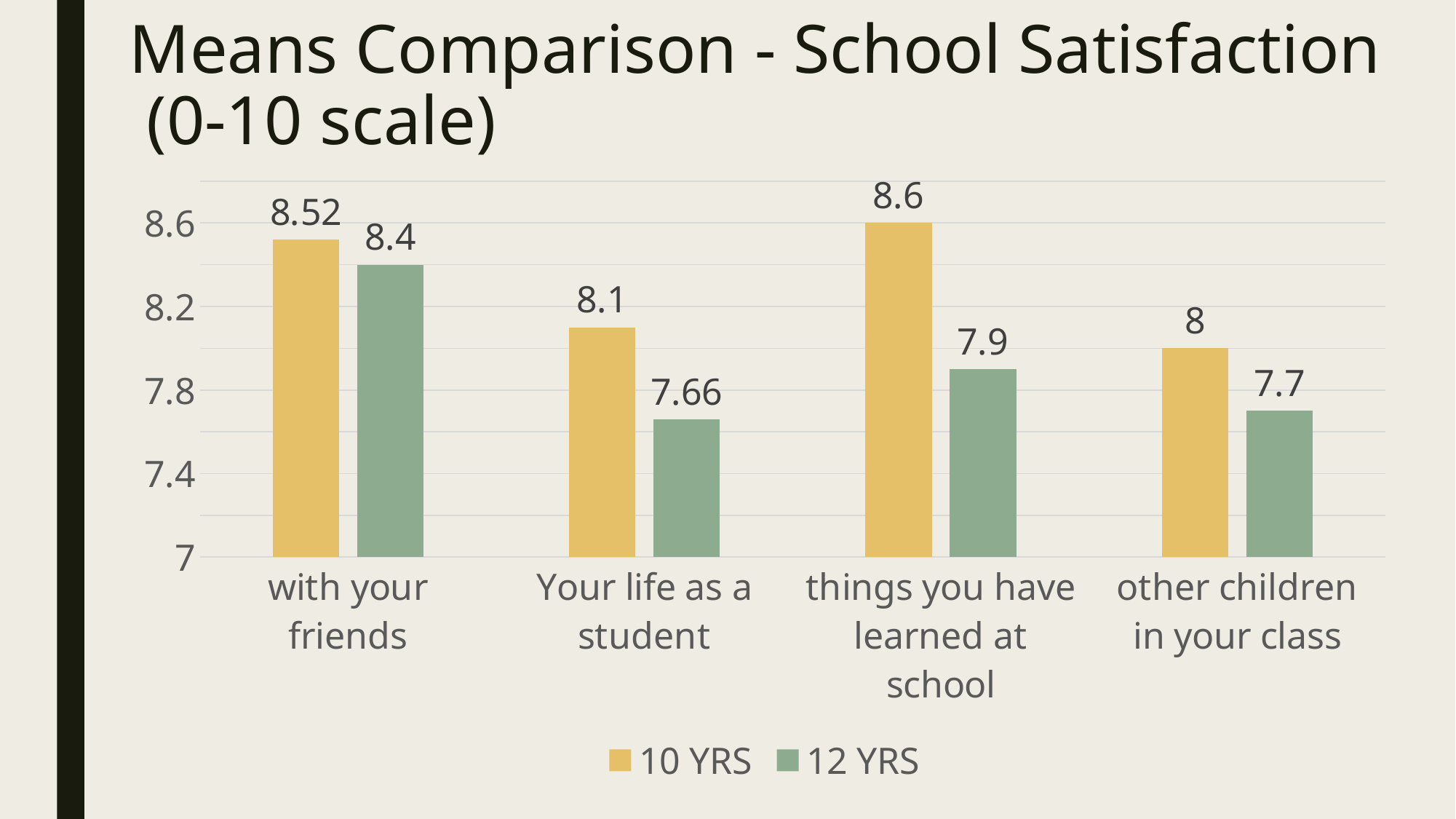
Which category has the highest 10 YRS value? things you have learned at school Which is larger for "with your friends": the 10 YRS value or the 12 YRS value? 10 YRS What is the 12 YRS value for "other children in your class"? 7.7 What is the difference between the 10 YRS and 12 YRS values for "things you have learned at school"? 0.7 How many series does the legend list? 2 Is the 12 YRS value for "things you have learned at school" greater or less than 8.2? less Which category has the lowest 12 YRS value? Your life as a student What is the 12 YRS value for "Your life as a student"? 7.66 What is the title of the chart on the slide? Means Comparison - School Satisfaction (0-10 scale) How many categories are shown on the x axis? 4 What kind of chart is shown on the slide? bar chart What is the 10 YRS value for "with your friends"? 8.52